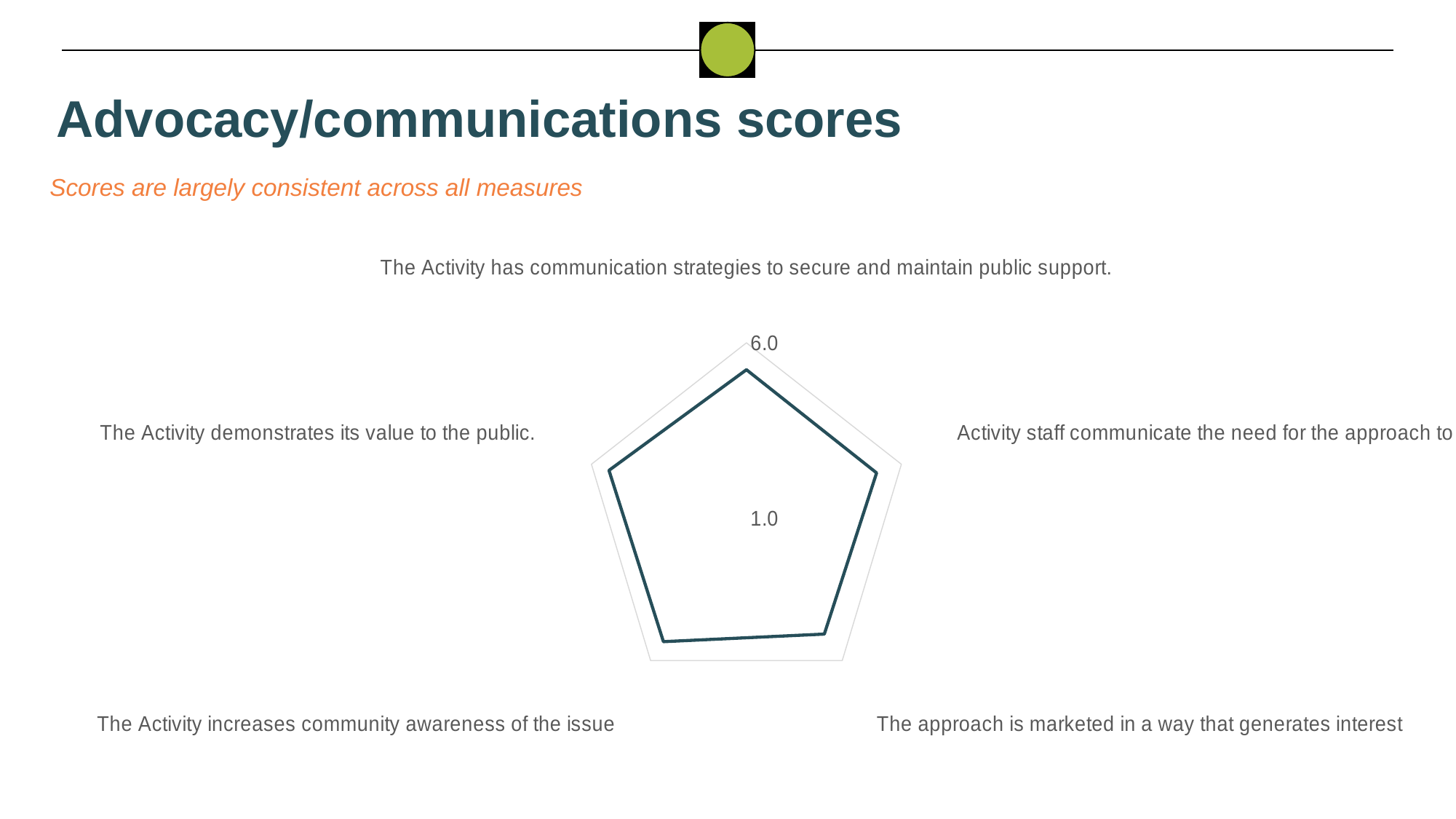
Is the value for "The Activity demonstrates its value to the public." greater or less than 1.0? greater What is the highest axis value labelled on the radar chart? 6.0 How many categories (measures) are plotted on the radar chart? 5 Is the value for "The Activity increases community awareness of the issue" greater or less than 1.0? greater What kind of chart is shown on the slide? Radar chart Is the value for "The Activity has communication strategies to secure and maintain public support." greater or less than 1.0? greater What is the title of the slide containing the radar chart? Advocacy/communications scores